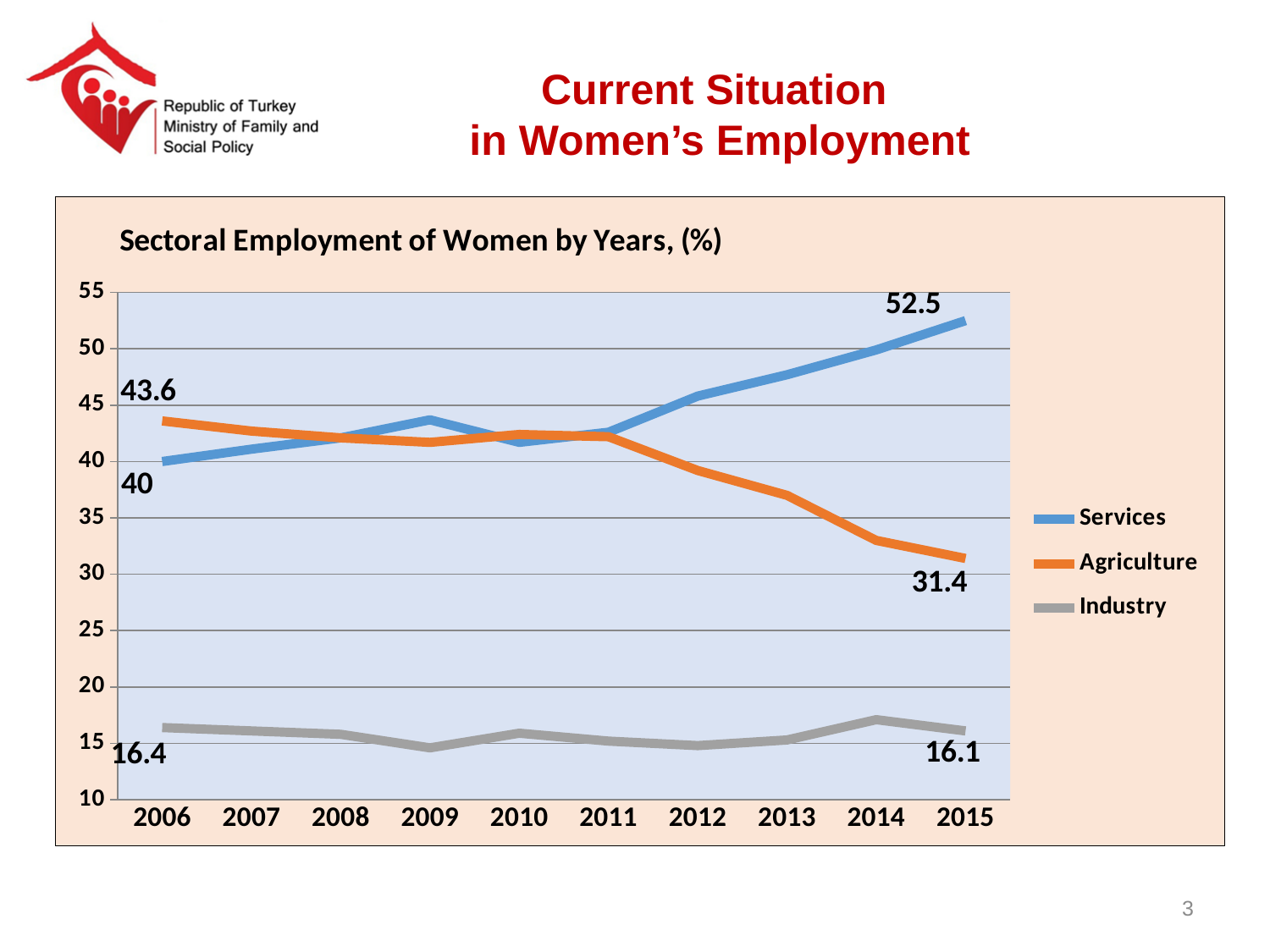
How many years are shown on the x axis? 10 What is the value for Services in 2015? 52.5 What is the value for Industry in 2015? 16.1 Does the Agriculture line rise or fall from 2006 to 2015? fall What is the difference between the Agriculture value in 2006 and in 2015? 12.2 By how much did the Services value increase from 2006 to 2015? 12.5 How many series does the legend list? 3 Which series has the lowest value in 2015? Industry Is the value for Agriculture in 2013 greater or less than 40? less Which series has the higher value in 2006, Services or Agriculture? Agriculture What is the value for Agriculture in 2006? 43.6 What is the value for Services in 2006? 40